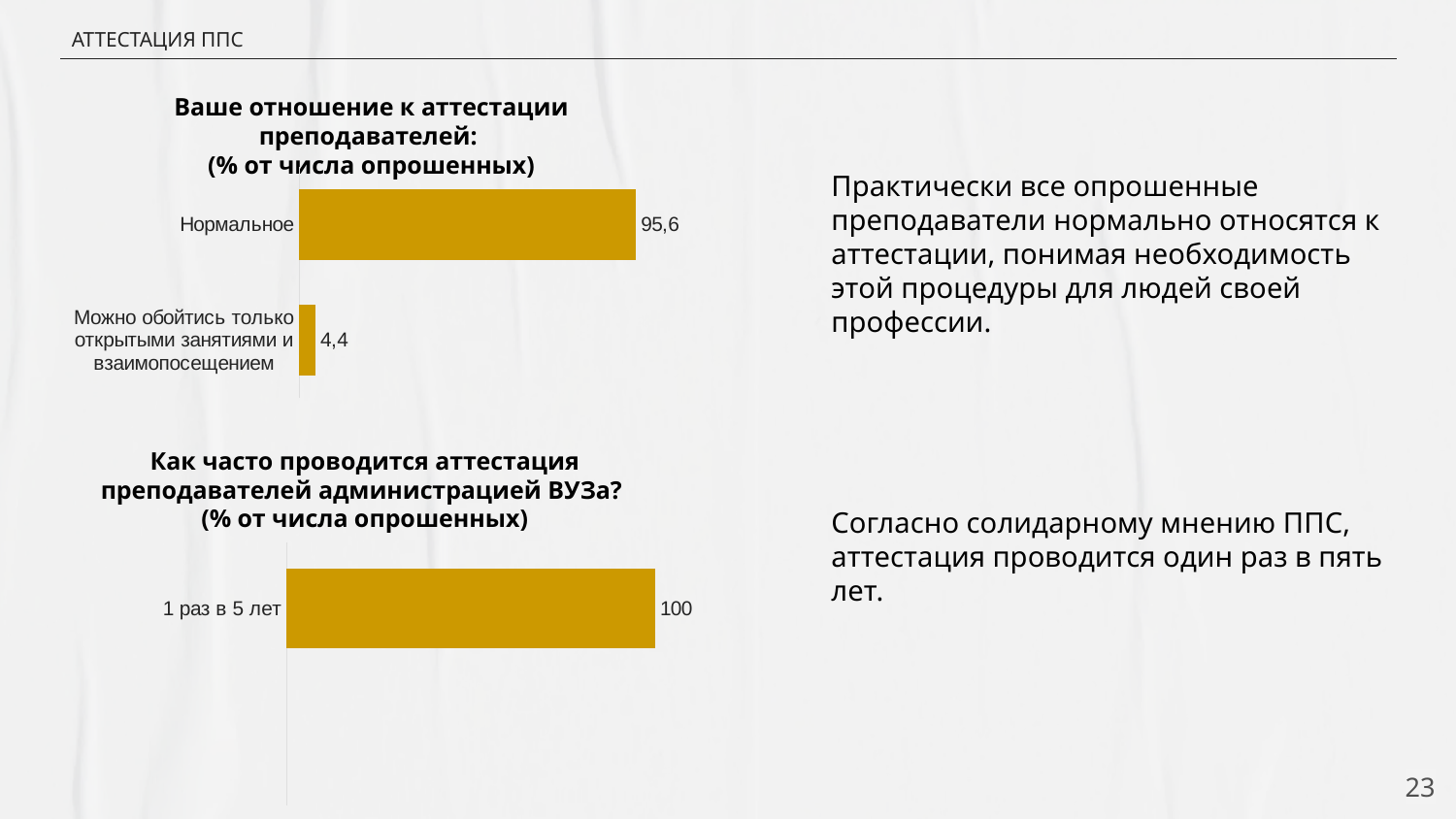
In the top chart 'Ваше отношение к аттестации преподавателей', which is larger: 'Нормальное' or 'Можно обойтись только открытыми занятиями и взаимопосещением'? Нормальное What colour are the bars in the top chart 'Ваше отношение к аттестации преподавателей'? Gold (dark yellow) What type of chart is the top chart 'Ваше отношение к аттестации преподавателей'? Bar chart How many categories are shown in the bottom chart 'Как часто проводится аттестация преподавателей администрацией ВУЗа?'? 1 In the top chart 'Ваше отношение к аттестации преподавателей', which category has the lowest value? Можно обойтись только открытыми занятиями и взаимопосещением What type of chart is the bottom chart 'Как часто проводится аттестация преподавателей администрацией ВУЗа?'? Bar chart In the top chart 'Ваше отношение к аттестации преподавателей', which category has the highest value? Нормальное How many categories are shown in the top chart 'Ваше отношение к аттестации преподавателей'? 2 In the bottom chart 'Как часто проводится аттестация преподавателей администрацией ВУЗа?', what is the value for '1 раз в 5 лет'? 100 In the top chart 'Ваше отношение к аттестации преподавателей', what is the value for 'Нормальное'? 95,6 In the top chart 'Ваше отношение к аттестации преподавателей', what is the value for 'Можно обойтись только открытыми занятиями и взаимопосещением'? 4,4 In the top chart 'Ваше отношение к аттестации преподавателей', what is the difference between the values for 'Нормальное' and 'Можно обойтись только открытыми занятиями и взаимопосещением'? 91,2